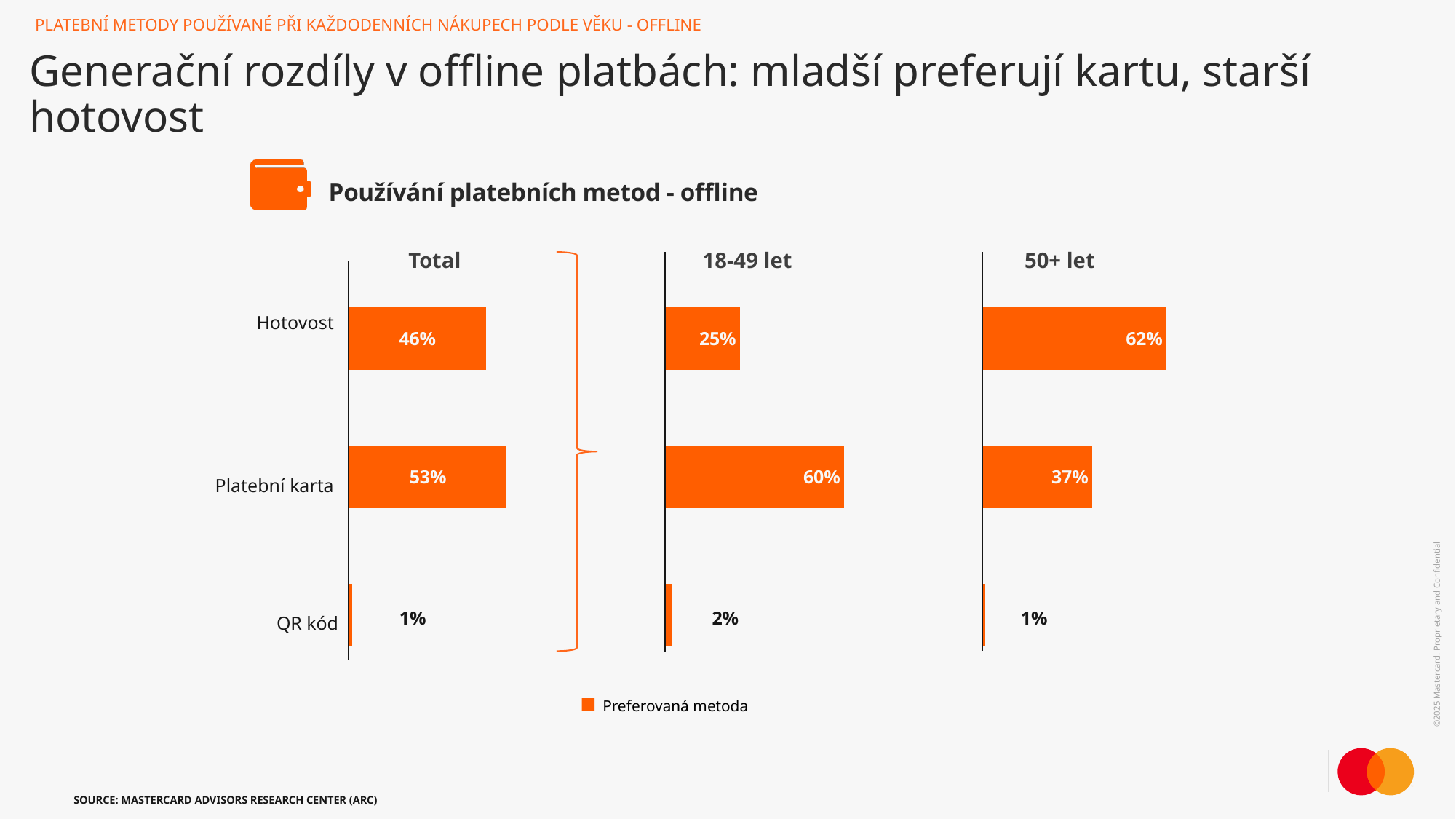
In the Total chart, what is the value for Hotovost? 46% In the 18-49 let chart, what is the value for Platební karta? 60% Which is larger: Hotovost in the 18-49 let chart or Hotovost in the 50+ let chart? Hotovost in the 50+ let chart In the 50+ let chart, what is the value for QR kód? 1% What is the legend entry shown below the charts? Preferovaná metoda In the 50+ let chart, what is the value for Hotovost? 62% In the 18-49 let chart, what is the difference between Platební karta and Hotovost? 35% In the 18-49 let chart, which payment method has the lowest value? QR kód In the 50+ let chart, what is the difference between Hotovost and Platební karta? 25% In the Total chart, which payment method has the highest value? Platební karta How many payment method categories are shown in each chart? 3 What type of chart is used on this slide? Bar chart